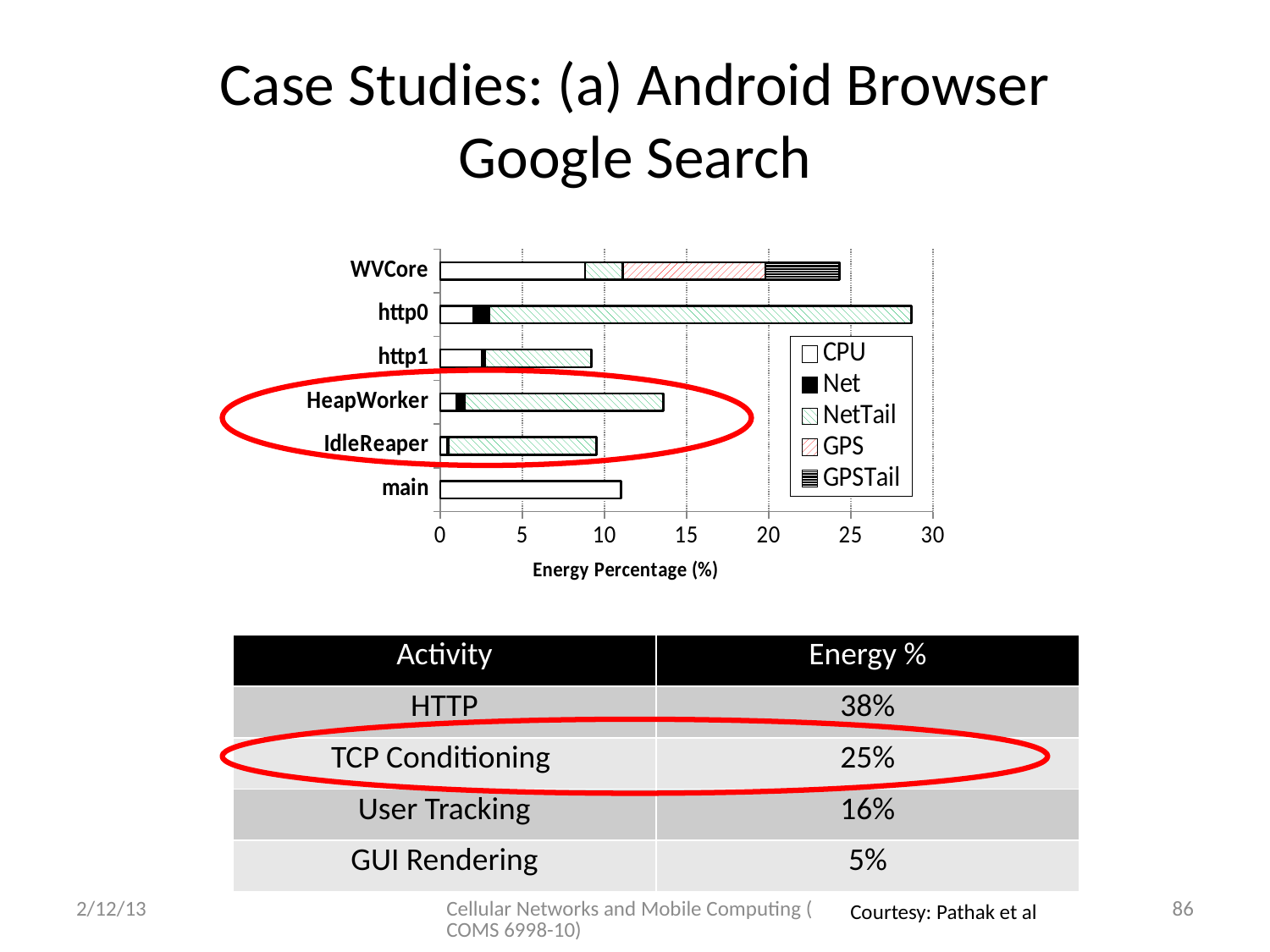
How many categories (threads) are plotted on the y axis of the chart? 6 How many series does the chart's legend list? 5 What is the title of the chart's x axis? Energy Percentage (%) Is the total bar for main greater or less than 10? greater Which category has the longest total bar in the chart? http0 Is the total bar for http0 greater or less than 25? greater Which has the longer total bar, HeapWorker or http1? HeapWorker What kind of chart is shown on the slide? bar chart Is the total bar for http1 greater or less than 10? less Which has the longer total bar, http0 or main? http0